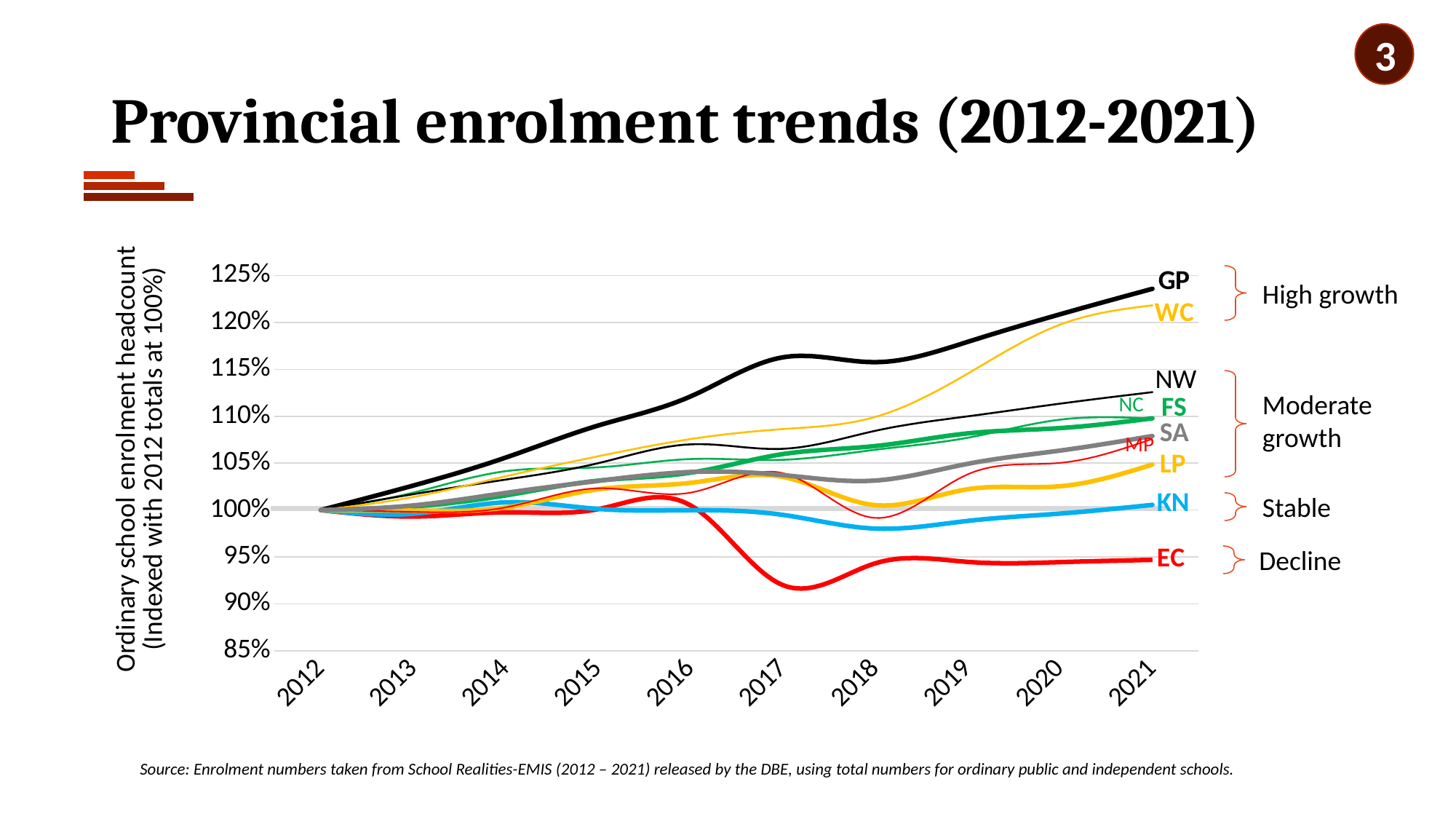
What is the indexed enrolment value for every province in 2012? 100% Which is larger in 2021, the value for GP or the value for EC? GP Which province is labelled as 'Decline' on the chart? EC What kind of chart is shown on the slide? line chart Does the GP line rise or fall from 2012 to 2021? rise How many years are shown along the x axis of the chart? 10 Is the value for WC in 2021 greater or less than 115%? greater Which province has the lowest indexed enrolment in 2021? EC How many provinces (lines) are plotted on the chart? 10 Is the value for GP in 2021 greater or less than 120%? greater Is the value for EC in 2017 greater or less than 95%? less Which province has the highest indexed enrolment in 2021? GP